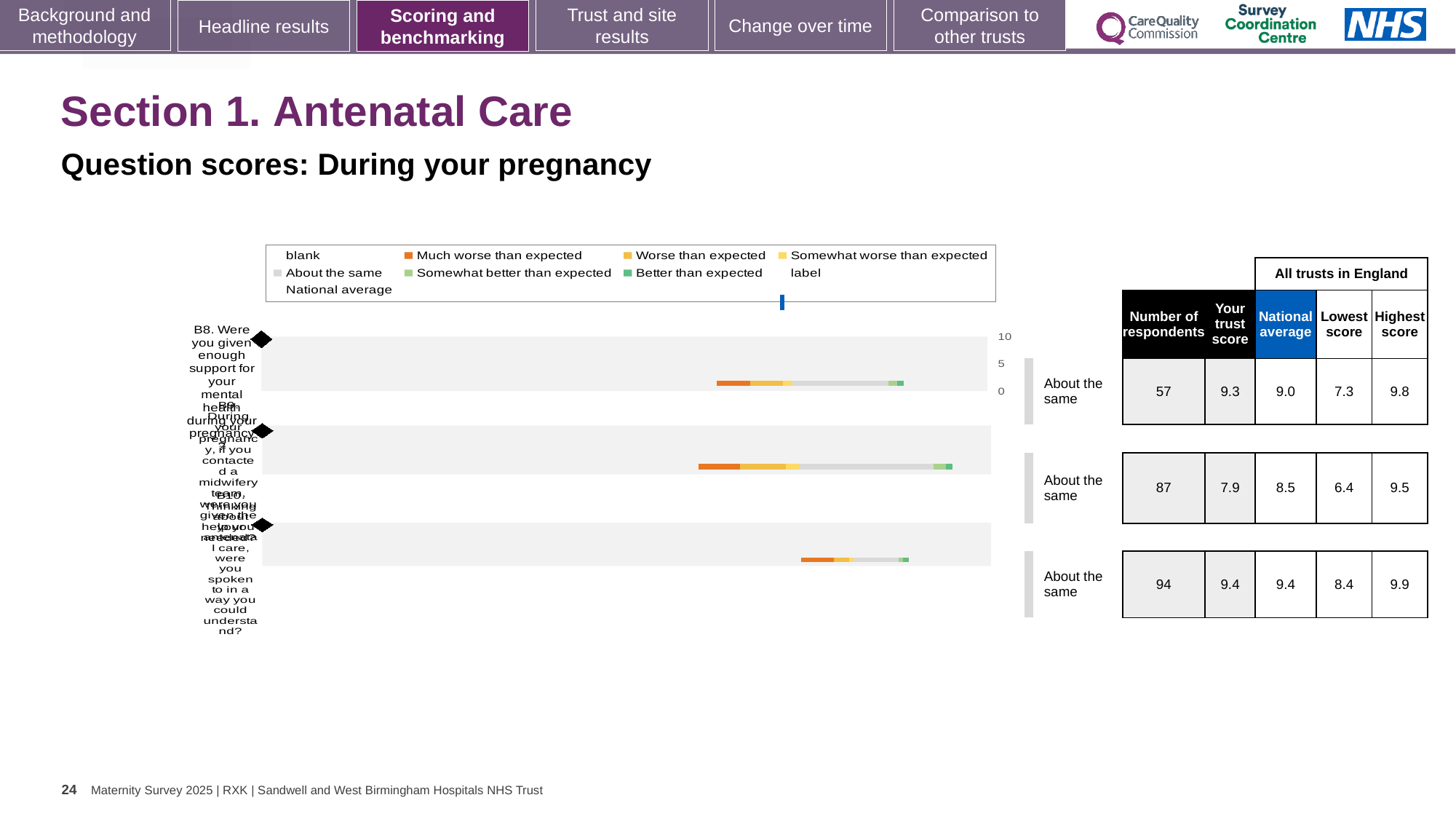
For the first row (B8), what is the difference between the highest score and the lowest score across all trusts in England? 2.5 Which row has the lowest number of respondents? the first row, B8 (57) Which row has the highest 'Your trust score'? the third row (9.4) For the second row, which is larger: the trust score or the national average? national average What is the 'Your trust score' for the second row of the chart? 7.9 What is the highest score among all trusts in England for the third row of the chart? 9.9 What benchmark rating is shown next to each of the three rows? About the same What kind of chart is shown on the slide? bar chart How many respondents are listed for the second row of the chart? 87 How many question rows (bars) does the chart show? 3 What is the national average for the first row (B8, mental health support)? 9.0 What is the 'Your trust score' for the first row, B8 about support for your mental health during pregnancy? 9.3